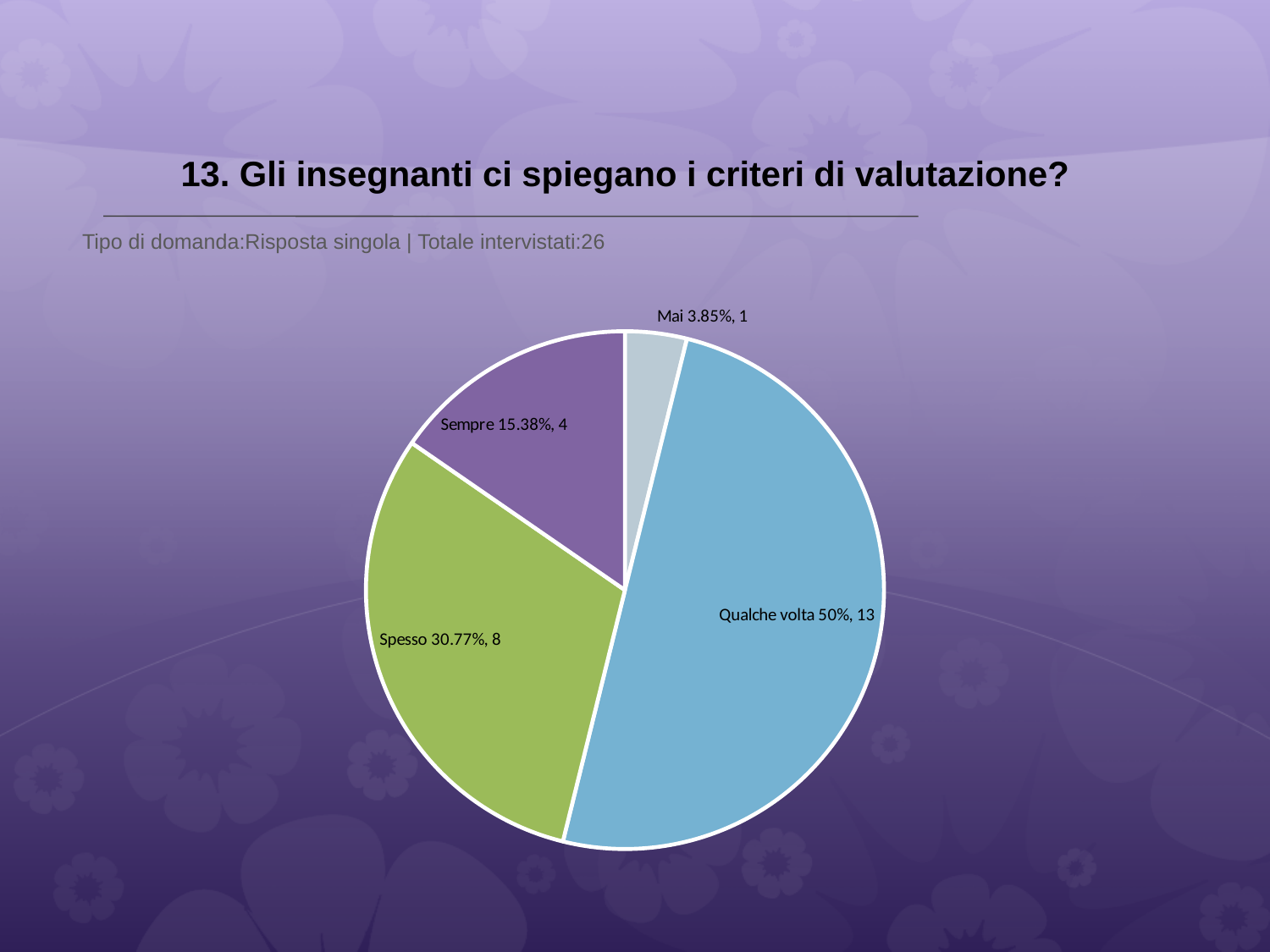
What is the total number of respondents across all slices? 26 What percentage share does the "Spesso" slice have? 30.77% How many respondents answered "Sempre"? 4 What is the title of the chart on the slide? 13. Gli insegnanti ci spiegano i criteri di valutazione? How many slices does the pie chart have? 4 What kind of chart is shown on the slide? pie chart How many respondents answered "Qualche volta"? 13 What is the difference in respondent count between "Qualche volta" and "Spesso"? 5 Which category has the largest slice? Qualche volta What percentage share does the "Mai" slice have? 3.85% Which has more respondents, "Sempre" or "Spesso"? Spesso Which category has the smallest slice? Mai